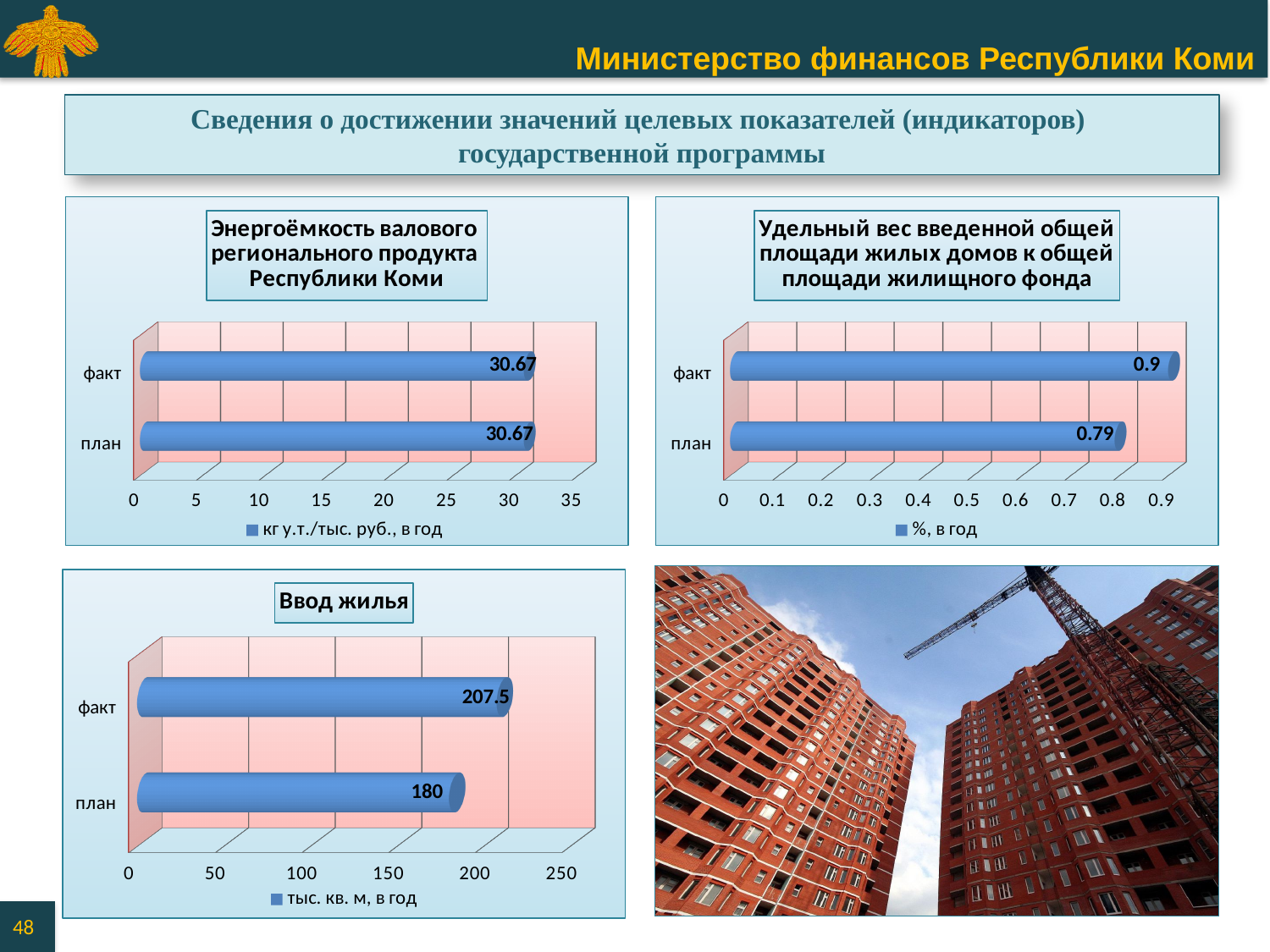
In the chart 'Энергоёмкость валового регионального продукта Республики Коми', what is the value for факт? 30.67 In the chart 'Ввод жилья', which is larger, факт or план? факт How many categories are shown in the chart 'Энергоёмкость валового регионального продукта Республики Коми'? 2 What unit does the legend of the chart 'Ввод жилья' show? тыс. кв. м, в год In the chart 'Удельный вес введенной общей площади жилых домов к общей площади жилищного фонда', which category has the highest value? факт In the chart 'Ввод жилья', what is the difference between факт and план? 27.5 In the chart 'Энергоёмкость валового регионального продукта Республики Коми', what is the difference between факт and план? 0 In the chart 'Удельный вес введенной общей площади жилых домов к общей площади жилищного фонда', what is the value for план? 0.79 What kind of chart is 'Ввод жилья'? bar chart In the chart 'Удельный вес введенной общей площади жилых домов к общей площади жилищного фонда', what is the value for факт? 0.9 In the chart 'Ввод жилья', what is the value for факт? 207.5 In the chart 'Ввод жилья', what is the value for план? 180